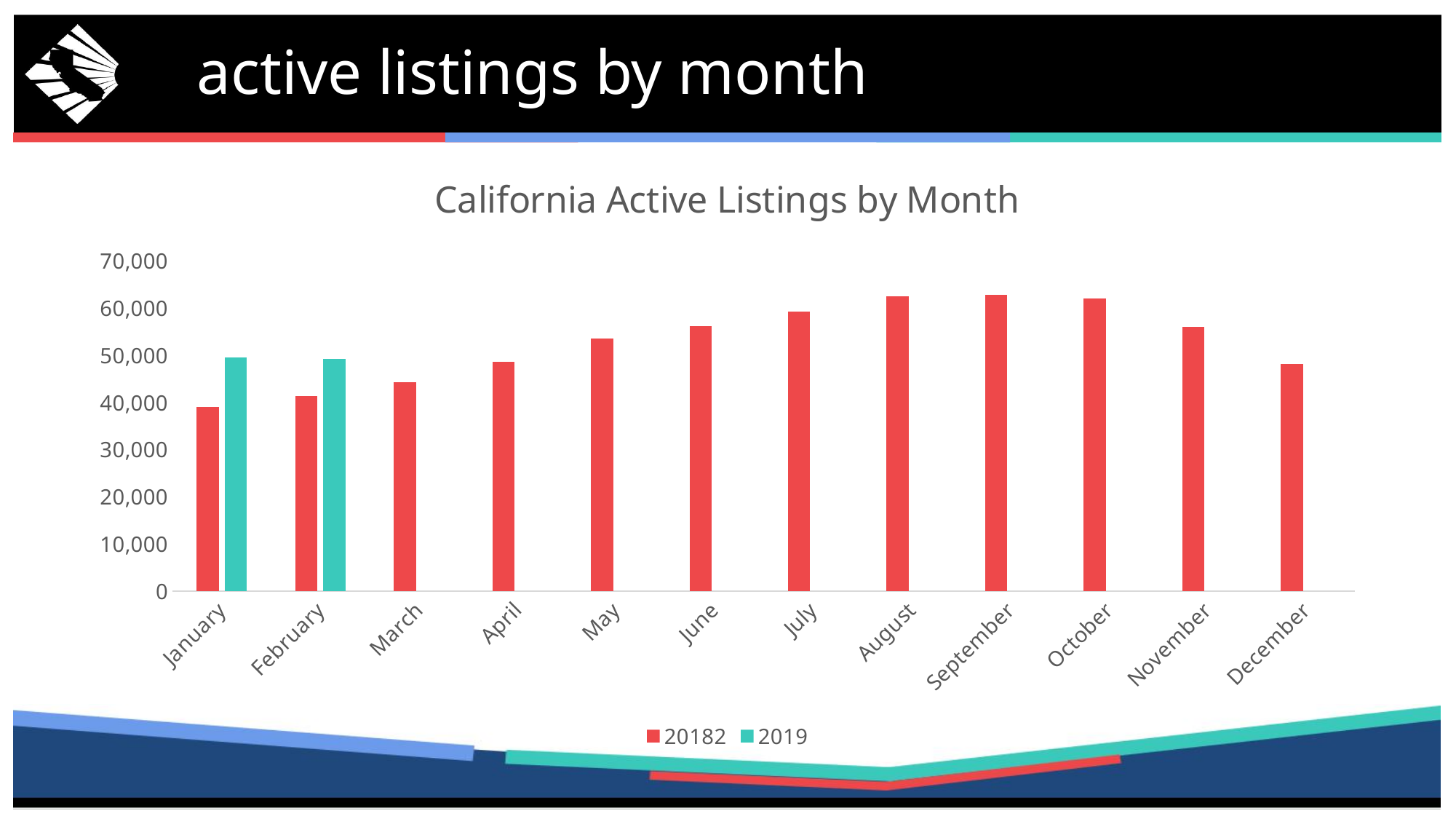
How do the 20182 values change from January to September? they rise Which month has the lowest value for the 20182 series? January Is the value for August in the 20182 series greater or less than 60,000? greater How many series does the legend list? 2 Is the value for March in the 20182 series greater or less than 50,000? less For January, which series has the larger value, 20182 or 2019? 2019 What kind of chart is shown on the slide? bar chart What is the title of the chart? California Active Listings by Month Is the value for January in the 2019 series greater or less than 40,000? greater What are the two series names shown in the legend? 20182 and 2019 How many months are shown on the x axis? 12 In the 20182 series, which is larger, August or December? August